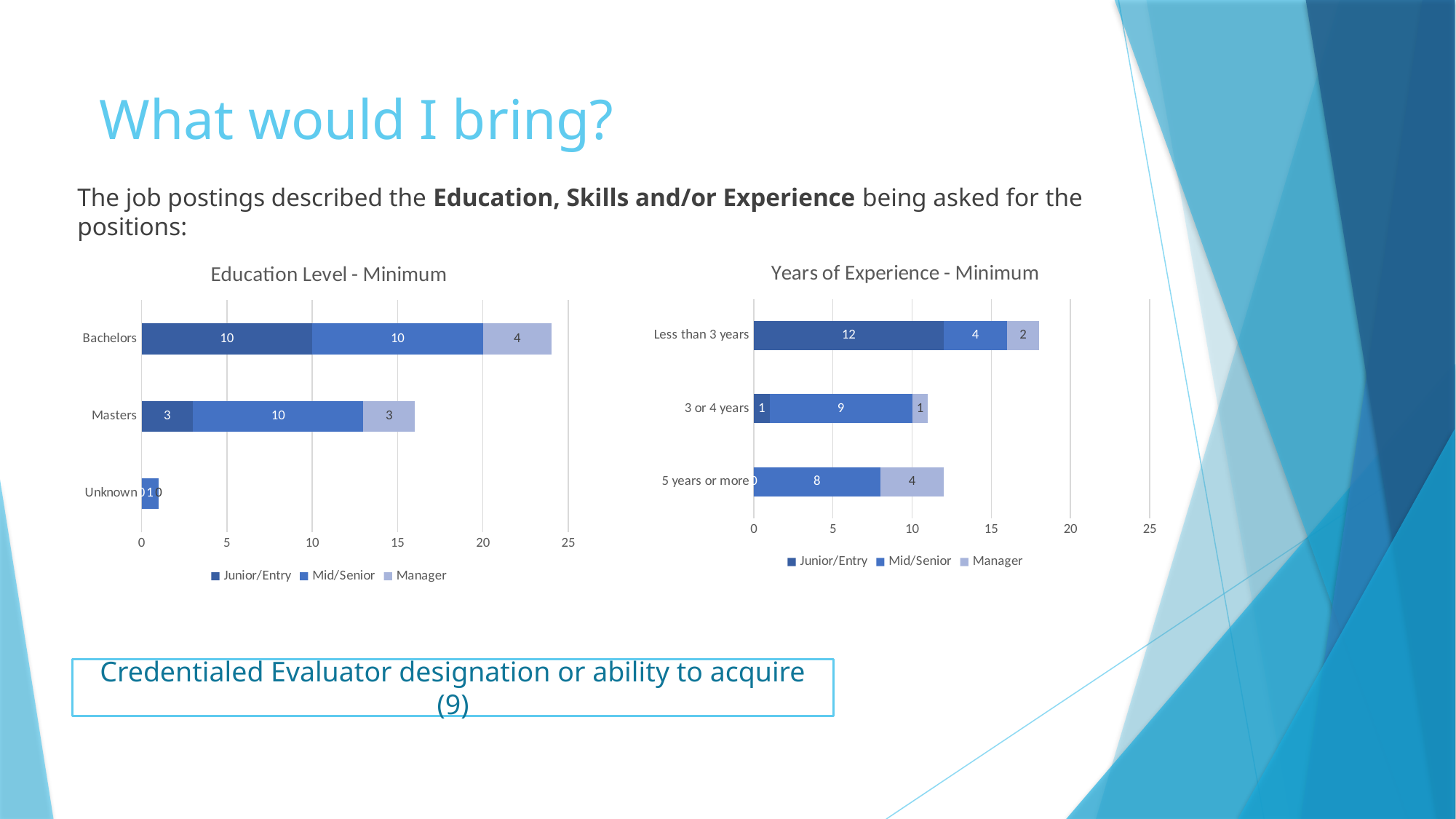
In the 'Education Level - Minimum' chart, what is the Junior/Entry value for Bachelors? 10 In the 'Years of Experience - Minimum' chart, what is the Junior/Entry value for 'Less than 3 years'? 12 In the 'Education Level - Minimum' chart, what is the total of the stacked bar for Masters? 16 What kind of chart is the 'Years of Experience - Minimum' chart? Stacked bar chart In the 'Years of Experience - Minimum' chart, what is the difference between the Mid/Senior values for '3 or 4 years' and 'Less than 3 years'? 5 In the 'Education Level - Minimum' chart, what is the Manager value for Masters? 3 In the 'Years of Experience - Minimum' chart, what is the total of the stacked bar for 'Less than 3 years'? 18 In the 'Education Level - Minimum' chart, how many series does the legend list? 3 In the 'Years of Experience - Minimum' chart, what is the Mid/Senior value for '3 or 4 years'? 9 In the 'Education Level - Minimum' chart, what is the total of the stacked bar for Bachelors? 24 In the 'Years of Experience - Minimum' chart, which category has the highest Junior/Entry value? Less than 3 years In the 'Years of Experience - Minimum' chart, what is the Manager value for '5 years or more'? 4